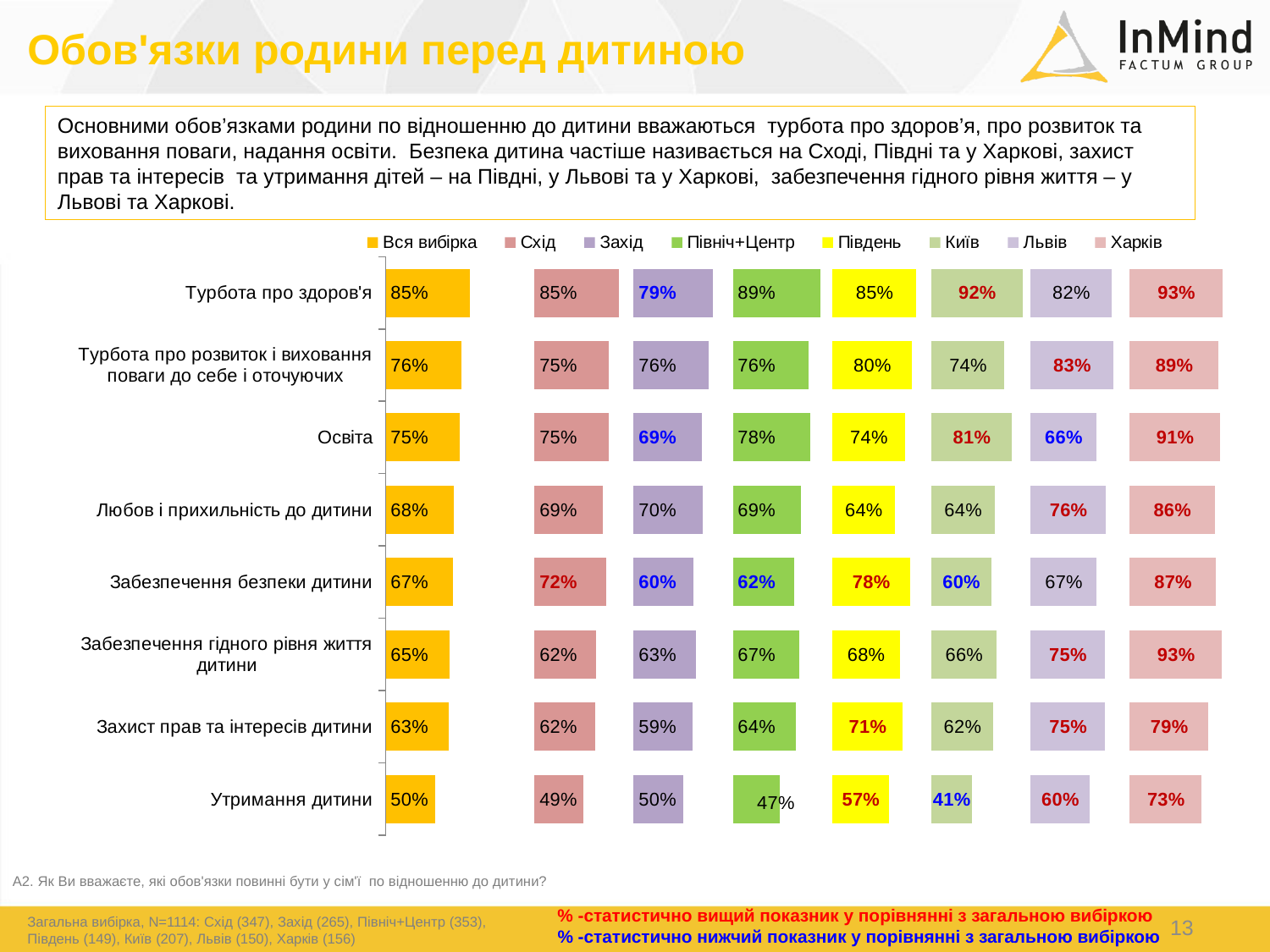
Which category has the lowest value for "Вся вибірка"? Утримання дитини What is the value for "Харків" for "Освіта"? 91% What kind of chart is shown on the slide? Bar chart What is the value for "Південь" for "Забезпечення безпеки дитини"? 78% How many categories (obligations) are shown in the chart? 8 What is the difference between the "Харків" and "Вся вибірка" values for "Утримання дитини"? 23% Which region series has the highest value for "Забезпечення гідного рівня життя дитини"? Харків Which is larger for "Освіта": the value for "Київ" or the value for "Львів"? Київ How many series does the legend list? 8 What is the value for "Вся вибірка" for "Турбота про здоров'я"? 85% What is the first series listed in the chart legend? Вся вибірка What is the value for "Київ" for "Утримання дитини"? 41%